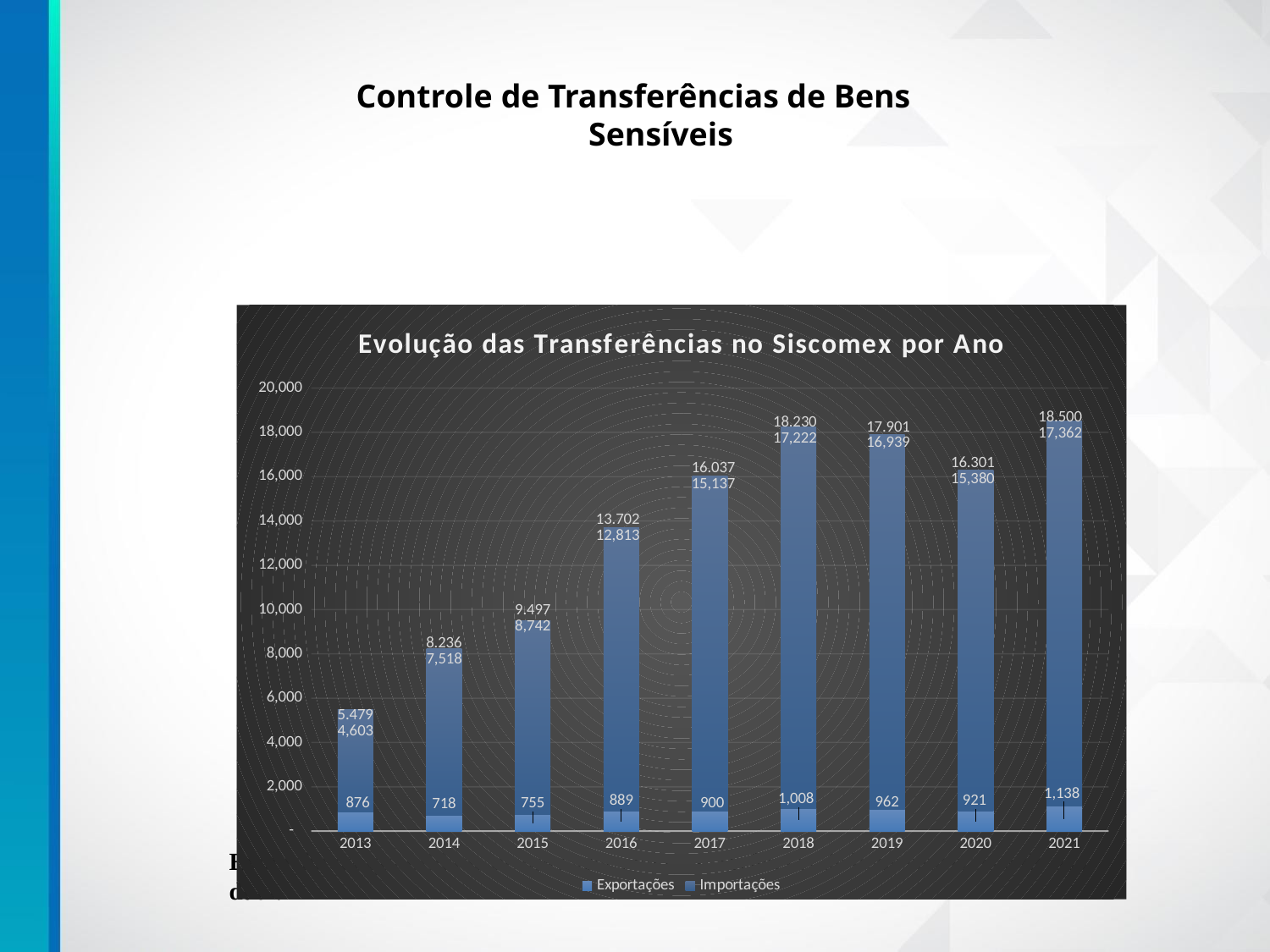
How many years are shown on the x axis? 9 What is the total printed above the bar for 2021? 18.500 What is the value of Importações in 2016? 12,813 Which is larger, Exportações in 2019 or Exportações in 2020? Exportações in 2019 What is the difference between Importações in 2018 and Importações in 2019? 283 Which year has the highest value for Importações? 2021 Which year has the lowest value for Exportações? 2014 How many series does the legend list? 2 What type of chart is shown on the slide? stacked bar chart What is the title of the chart? Evolução das Transferências no Siscomex por Ano Do the Importações values generally rise or fall from 2013 to 2018? rise What is the value of Exportações in 2018? 1,008